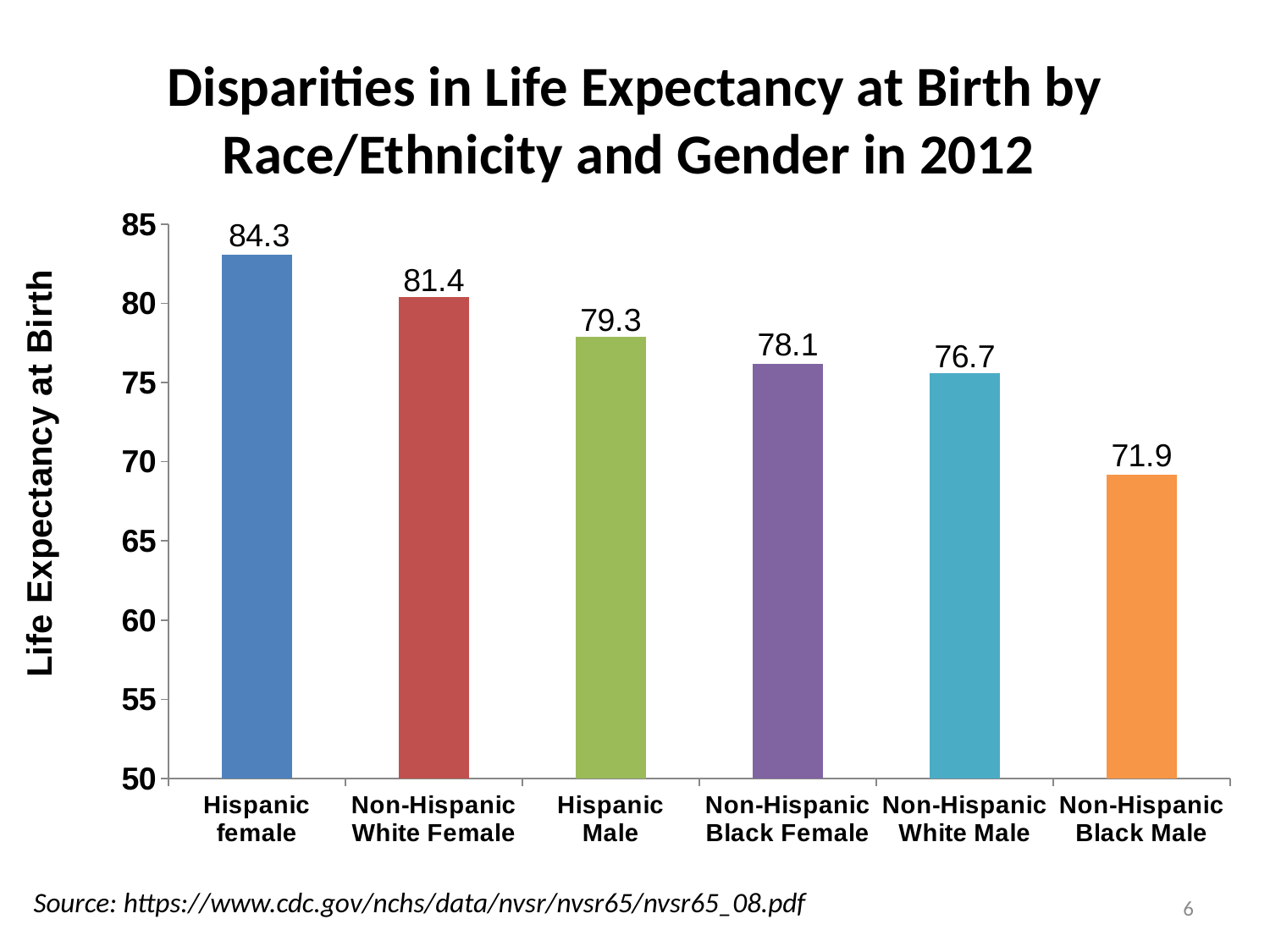
What is the difference in life expectancy between Non-Hispanic White Female and Non-Hispanic White Male? 4.7 What kind of chart is shown on the slide? Bar chart Is the value for Non-Hispanic Black Female greater or less than 75? greater What is the life expectancy at birth for Non-Hispanic White Male? 76.7 Which category has the highest life expectancy at birth? Hispanic female Which category has the lowest life expectancy at birth? Non-Hispanic Black Male What is the label of the vertical axis? Life Expectancy at Birth Which has a higher life expectancy at birth, Hispanic Male or Non-Hispanic Black Female? Hispanic Male What is the life expectancy at birth for Non-Hispanic Black Male? 71.9 How many categories are shown in the chart? 6 What is the difference in life expectancy between Hispanic female and Non-Hispanic Black Male? 12.4 What is the life expectancy at birth for Hispanic female? 84.3